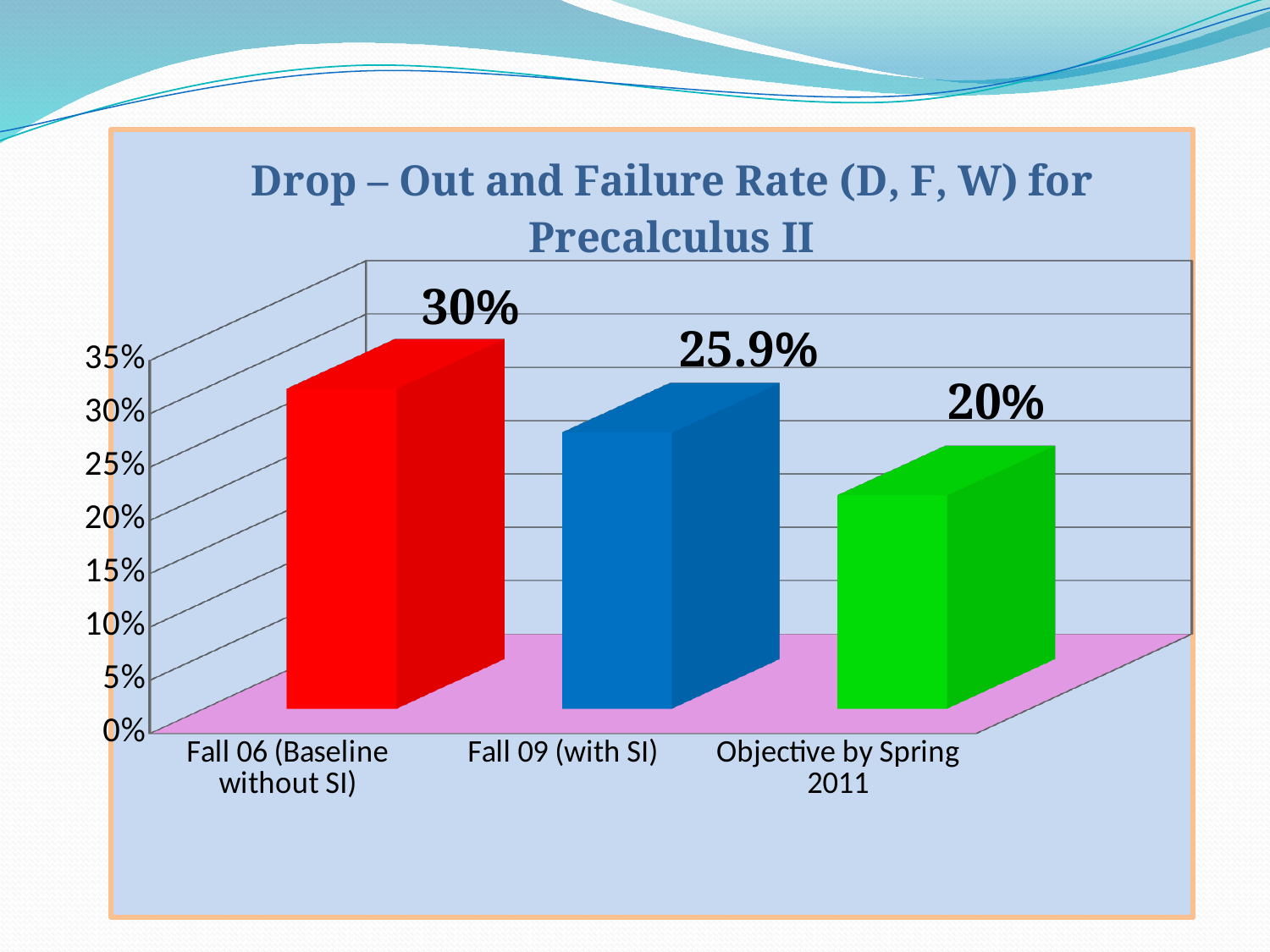
Which category has the highest drop-out and failure rate? Fall 06 (Baseline without SI) Which category has the lowest value on the chart? Objective by Spring 2011 Which is larger, the value for Fall 09 (with SI) or the value for Objective by Spring 2011? Fall 09 (with SI) What is the difference between the Fall 06 (Baseline without SI) rate and the Fall 09 (with SI) rate? 4.1% What is the drop-out and failure rate for Fall 06 (Baseline without SI)? 30% What kind of chart is shown on the slide? Bar chart Do the values rise or fall from left to right across the categories? Fall What is the difference between the Fall 06 (Baseline without SI) rate and the Objective by Spring 2011 value? 10% What is the value shown for Objective by Spring 2011? 20% What is the title of the chart? Drop – Out and Failure Rate (D, F, W) for Precalculus II How many categories are shown on the chart? 3 What is the drop-out and failure rate for Fall 09 (with SI)? 25.9%